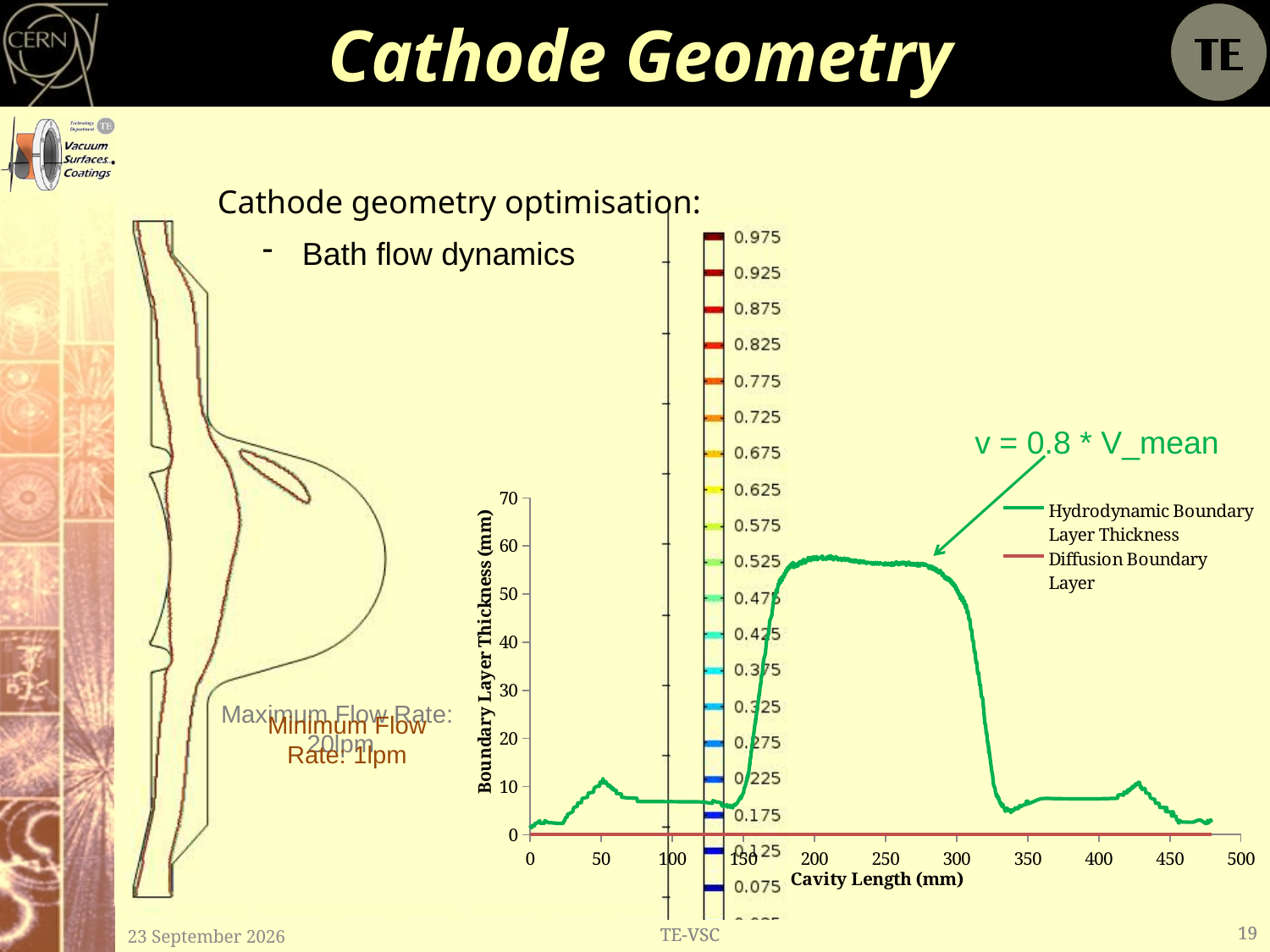
How many series does the chart's legend list? 2 Does the Hydrodynamic Boundary Layer Thickness rise or fall between cavity lengths of 300 mm and 350 mm? fall Is the Hydrodynamic Boundary Layer Thickness at a cavity length of 400 mm greater or less than 10? less Does the Hydrodynamic Boundary Layer Thickness rise or fall between cavity lengths of 150 mm and 200 mm? rise Is the Diffusion Boundary Layer value at a cavity length of 250 mm greater or less than 10? less Which is larger: the Hydrodynamic Boundary Layer Thickness at 250 mm or at 450 mm? at 250 mm Is the Hydrodynamic Boundary Layer Thickness at a cavity length of 50 mm greater or less than 20? less What is the label of the x axis of the chart? Cavity Length (mm) Which series is plotted in green on the chart? Hydrodynamic Boundary Layer Thickness What is the label of the y axis of the chart? Boundary Layer Thickness (mm) What kind of chart is shown on the slide? line chart